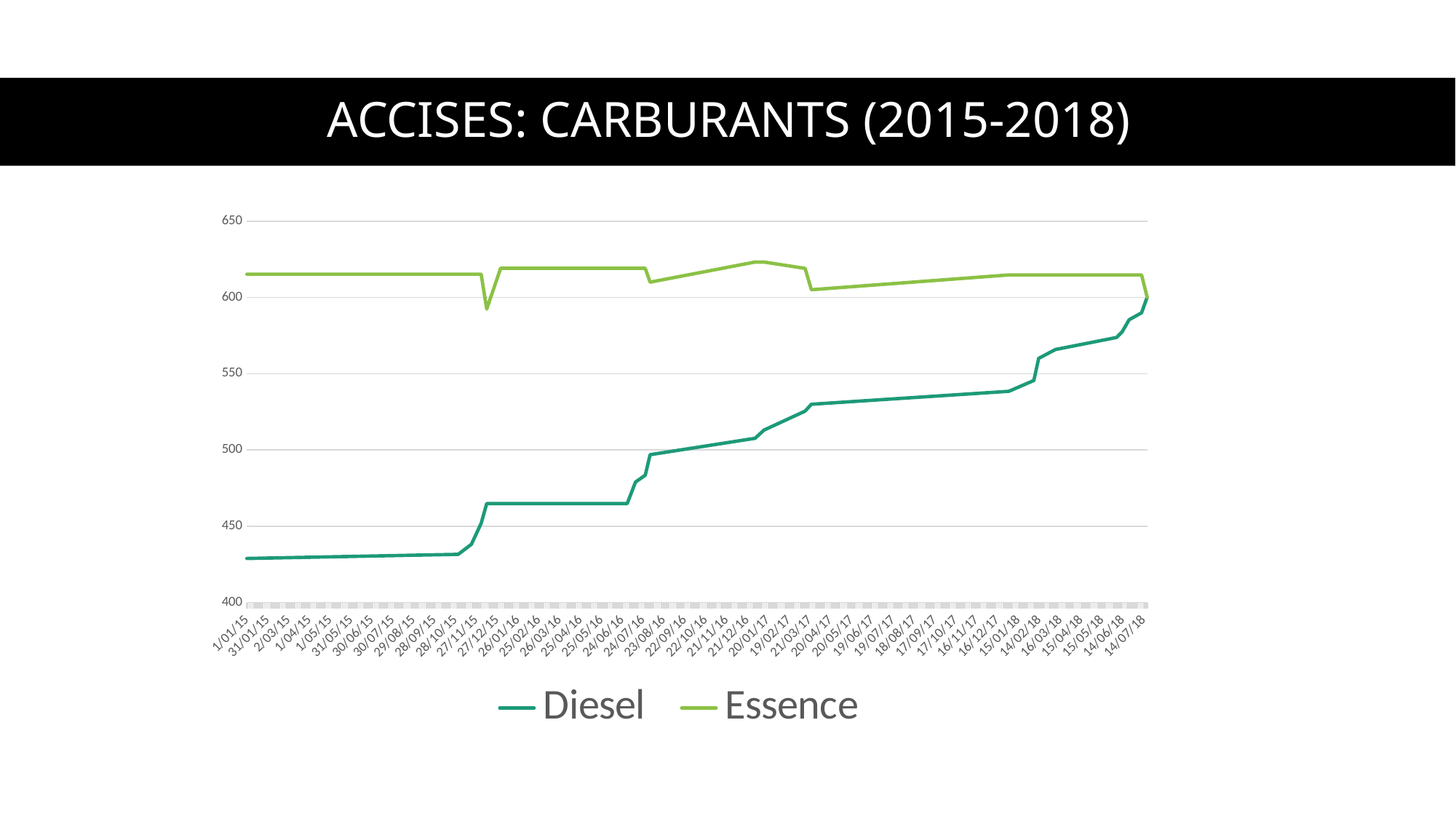
Is the value for Diesel at 1/01/15 greater or less than 450? less Does the Diesel line generally rise or fall from 1/01/15 to 14/07/18? rise Which series has the higher value at 1/01/15, Diesel or Essence? Essence Which series is plotted in the lighter green colour? Essence Is the value for Diesel at 20/04/17 greater or less than 500? greater Is the value for Essence at 20/01/17 greater or less than 600? greater How many series does the legend list? 2 What kind of chart is shown on the slide? line chart What is the title of the chart? ACCISES: CARBURANTS (2015-2018)